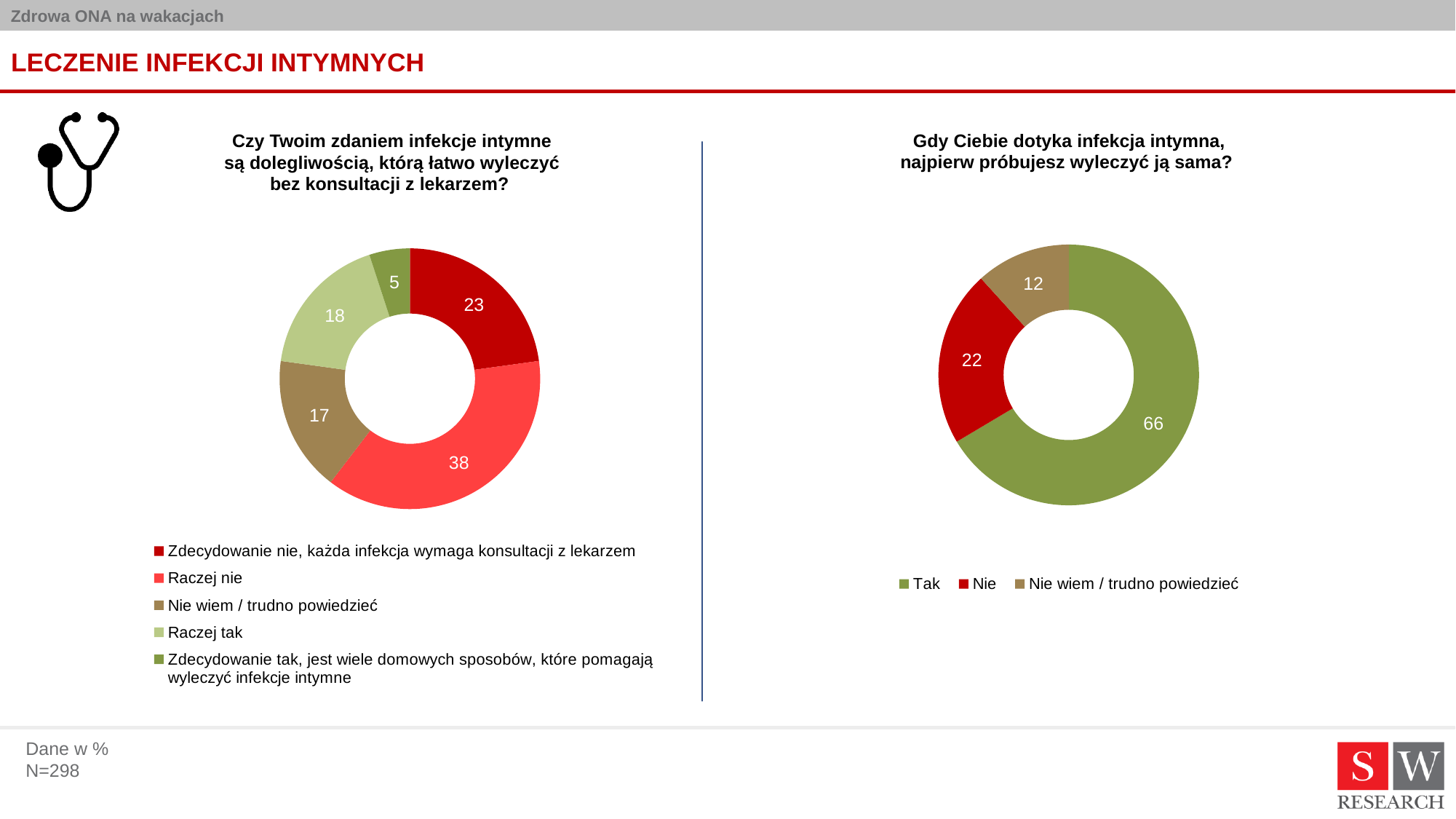
In the left chart ("Czy Twoim zdaniem infekcje intymne są dolegliwością, którą łatwo wyleczyć bez konsultacji z lekarzem?"), what is the value for "Raczej nie"? 38 In the left chart, what is the difference between "Raczej nie" and "Zdecydowanie nie, każda infekcja wymaga konsultacji z lekarzem"? 15 In the left chart, what is the value for "Raczej tak"? 18 In the right chart, what is the value for "Nie wiem / trudno powiedzieć"? 12 In the right chart ("Gdy Ciebie dotyka infekcja intymna, najpierw próbujesz wyleczyć ją sama?"), what is the value for "Tak"? 66 In the left chart, what is the value for "Zdecydowanie nie, każda infekcja wymaga konsultacji z lekarzem"? 23 How many categories does the left chart show? 5 In the left chart, which category has the smallest value? Zdecydowanie tak, jest wiele domowych sposobów, które pomagają wyleczyć infekcje intymne What type of chart is used on the right side of the slide? Doughnut chart In the right chart, what is the difference between "Tak" and "Nie"? 44 In the right chart, which is larger, "Nie" or "Nie wiem / trudno powiedzieć"? Nie In the left chart, which category has the largest value? Raczej nie